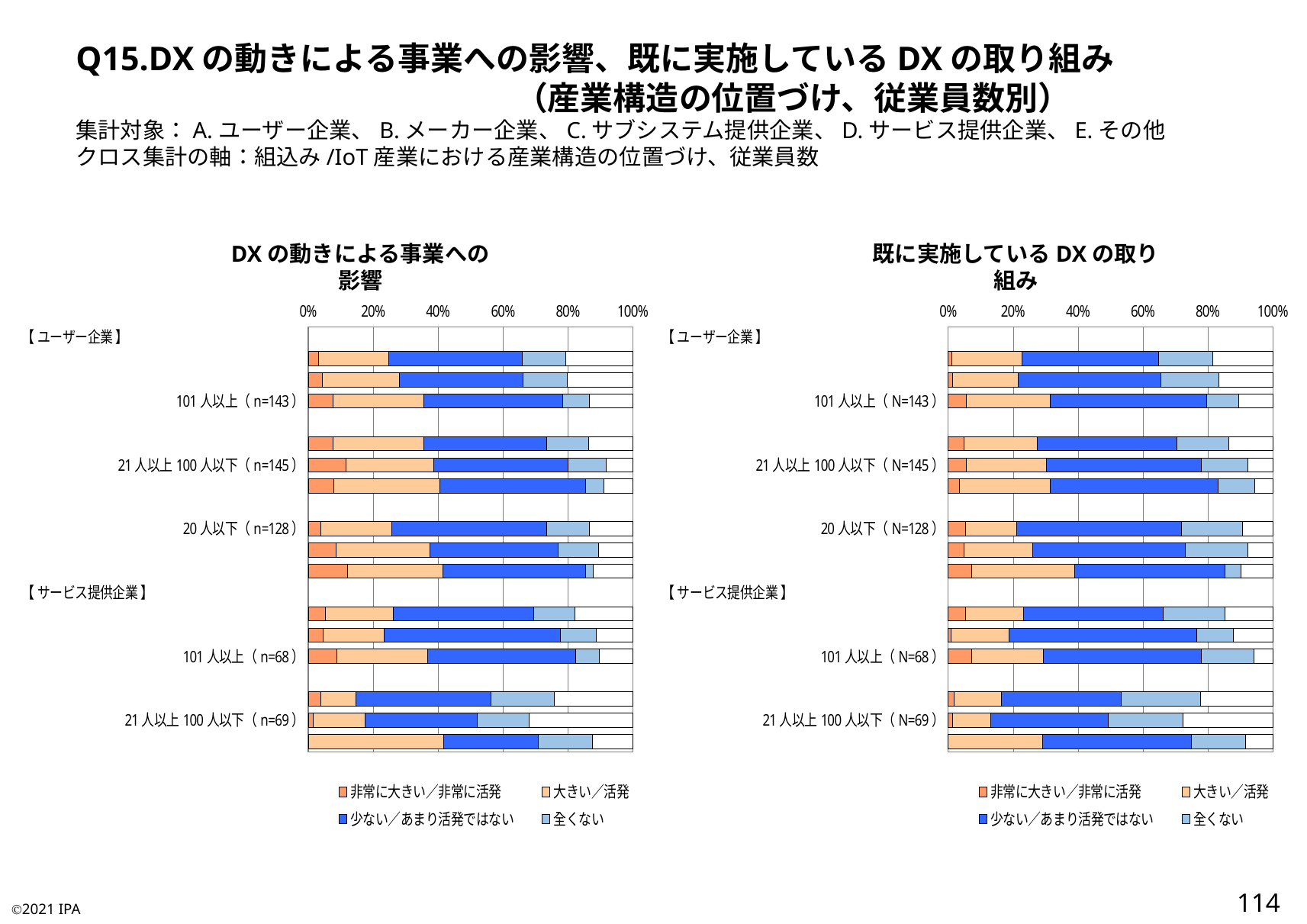
How many series does the legend of the left chart list? 4 What is the maximum value shown on the x axis of the right chart? 100% In the left chart, is the '非常に大きい／非常に活発' segment for 101人以上（n=143） greater or less than 20%? less In the right chart, which legend entry is shown in light blue? 全くない In the left chart, is the '少ない／あまり活発ではない' segment for 101人以上（n=143） greater or less than 20%? greater In the right chart, is the '少ない／あまり活発ではない' segment for 21人以上100人以下（N=69） greater or less than 20%? greater What kind of chart is the left chart titled 'DXの動きによる事業への影響'? Stacked bar chart How many series does the legend of the right chart list? 4 In the left chart, which legend entry is shown in dark blue? 少ない／あまり活発ではない What kind of chart is the right chart titled '既に実施しているDXの取り組み'? Stacked bar chart